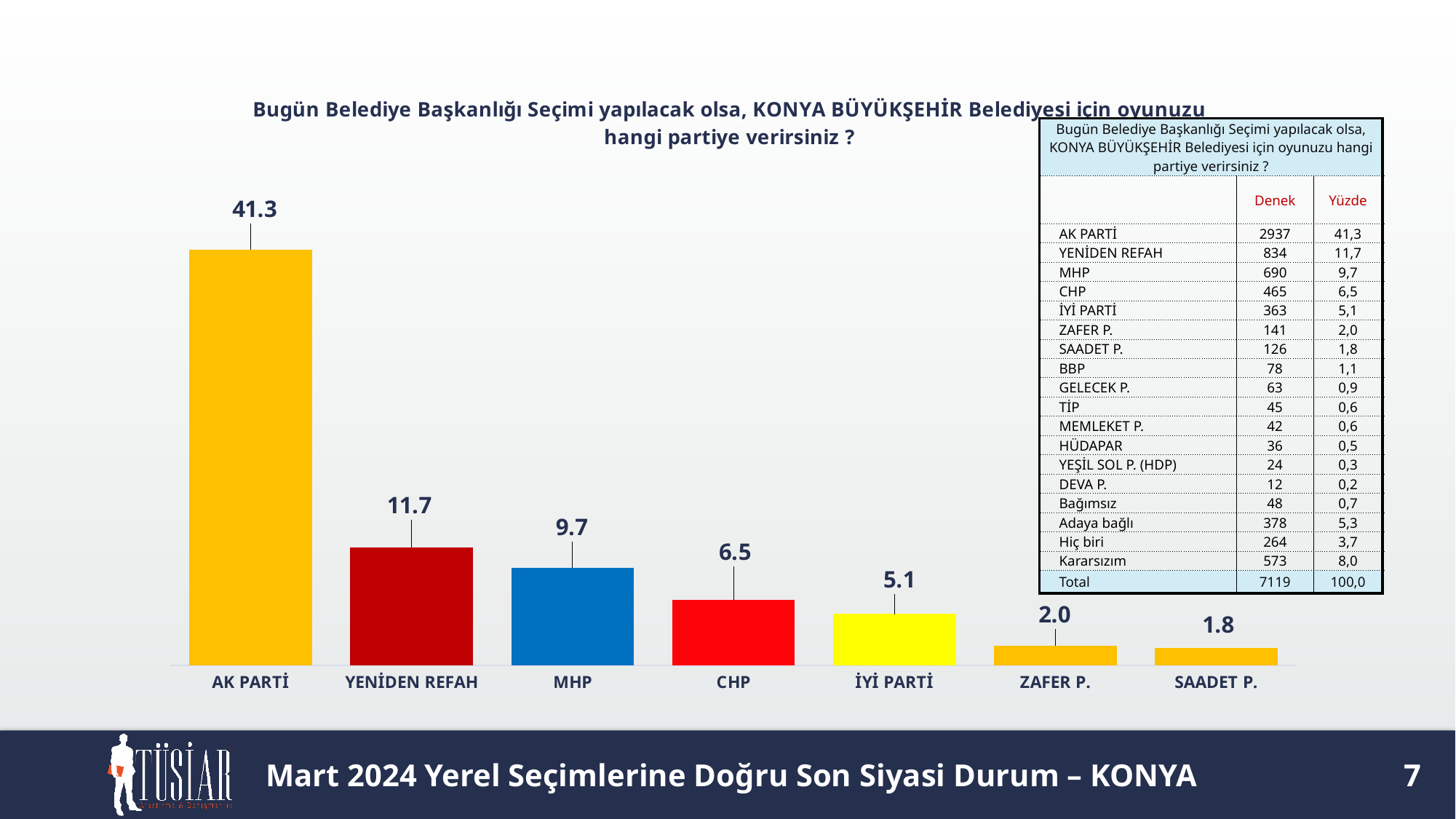
How many parties are shown as bars in the bar chart? 7 What colour is the bar for MHP in the bar chart? blue Which party has the lowest value in the bar chart? SAADET P. Which party has the highest value in the bar chart? AK PARTİ What is the value shown for AK PARTİ in the bar chart? 41.3 What type of chart is shown on the slide? bar chart Do the values in the bar chart rise or fall from left to right? fall What is the difference between the values for AK PARTİ and YENİDEN REFAH in the bar chart? 29.6 What is the value shown for MHP in the bar chart? 9.7 What is the value shown for SAADET P. in the bar chart? 1.8 What is the difference between the values for CHP and İYİ PARTİ in the bar chart? 1.4 Which has a larger value in the bar chart, MHP or CHP? MHP